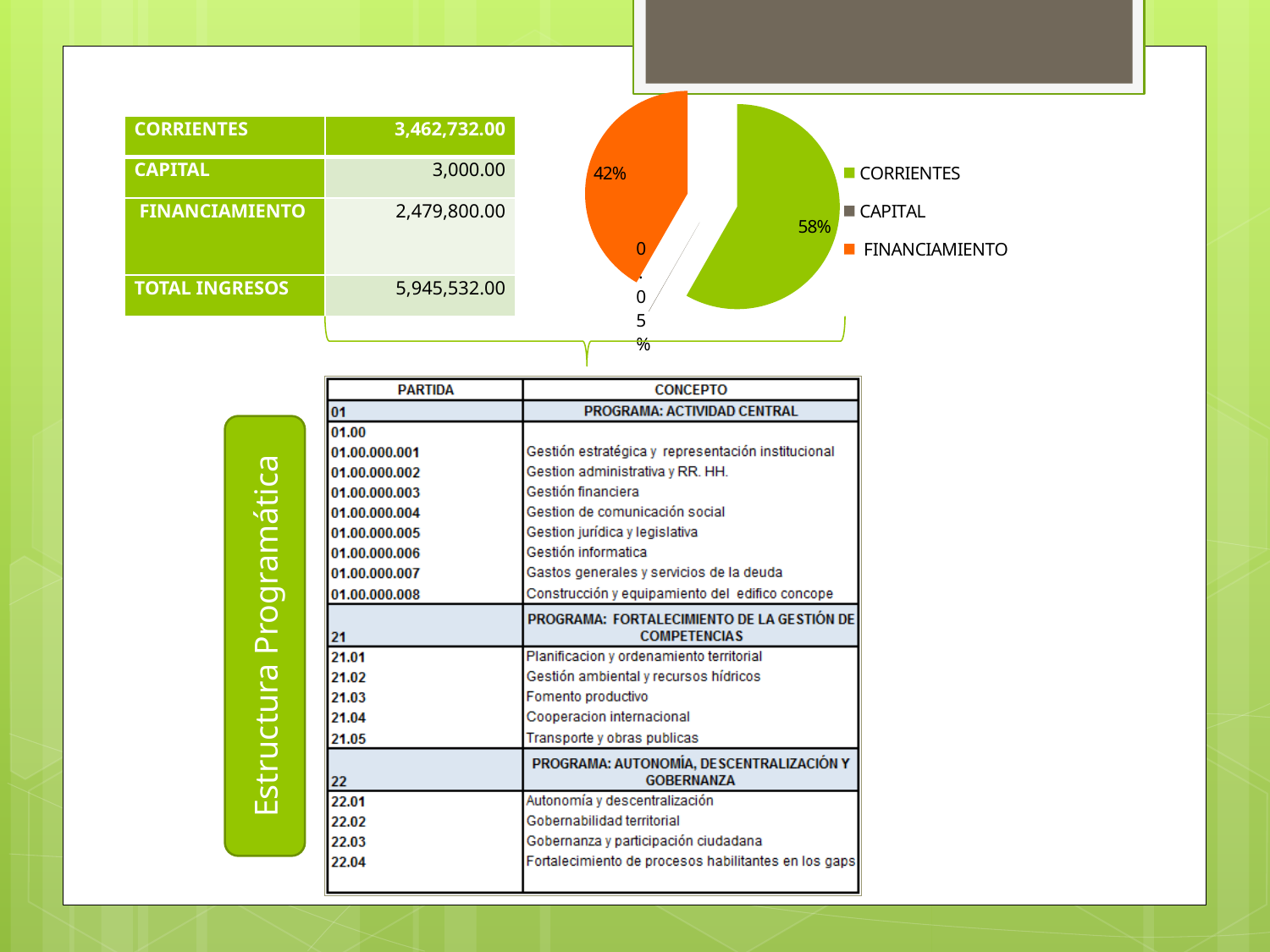
In the pie chart, which is larger, the CORRIENTES slice or the FINANCIAMIENTO slice? CORRIENTES Which category has the largest slice in the pie chart? CORRIENTES What percentage does the pie chart show for CAPITAL? 0.05% What is the difference in percentage points between the CORRIENTES and FINANCIAMIENTO slices in the pie chart? 16 What colour is the FINANCIAMIENTO slice in the pie chart? orange Which category has the smallest slice in the pie chart? CAPITAL How many entries does the legend of the pie chart list? 3 How many slices does the pie chart have? 3 What colour is the CORRIENTES slice in the pie chart? green What percentage does the pie chart show for CORRIENTES? 58% What percentage does the pie chart show for FINANCIAMIENTO? 42% What kind of chart is shown at the top of the slide? pie chart